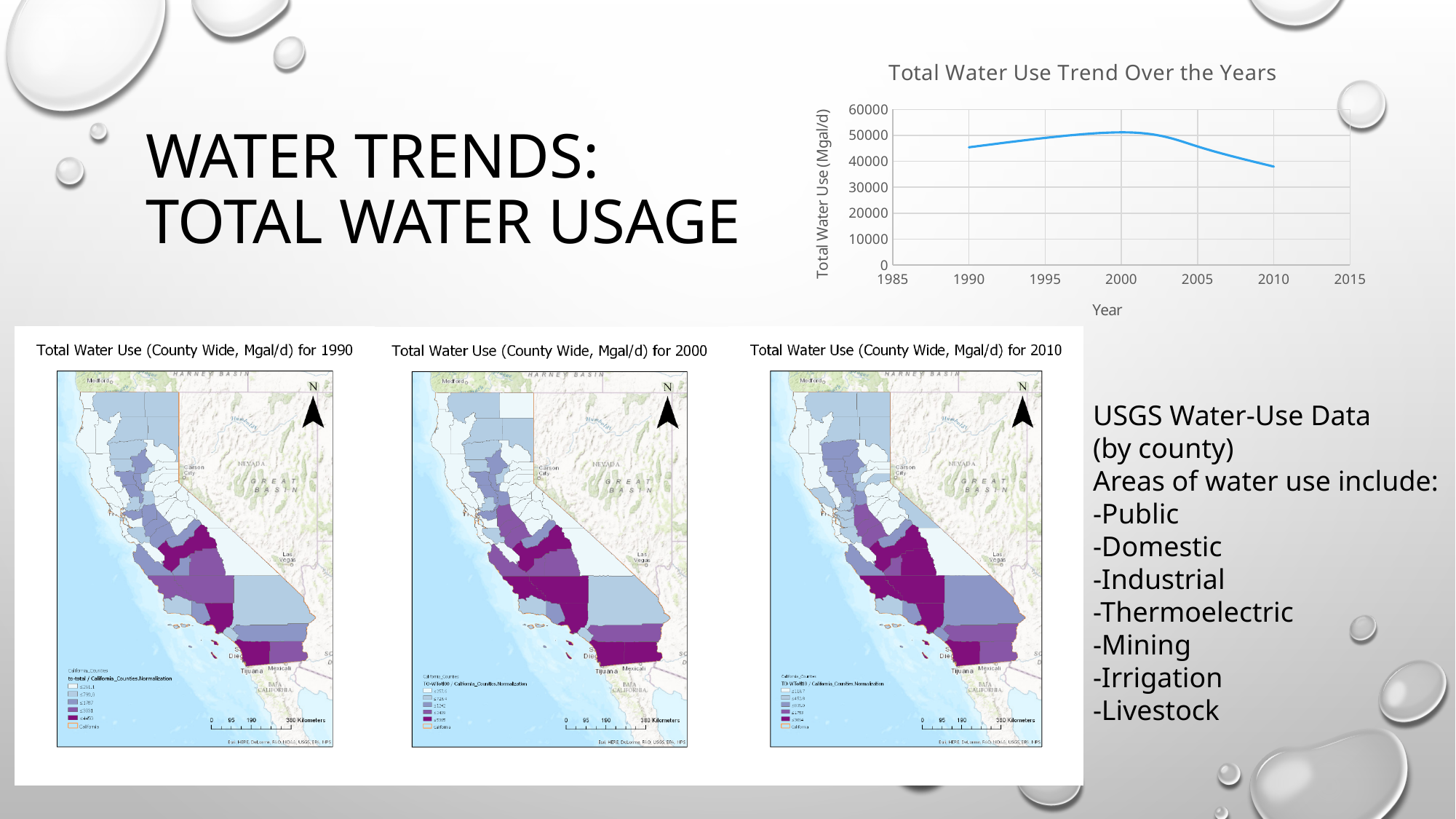
In the "Total Water Use Trend Over the Years" chart, does total water use rise or fall between 1990 and 2000? rise In the "Total Water Use Trend Over the Years" chart, what is the label of the y axis? Total Water Use (Mgal/d) In the "Total Water Use Trend Over the Years" chart, which year has the highest total water use? 2000 In the "Total Water Use Trend Over the Years" chart, does total water use rise or fall between 2000 and 2010? fall In the "Total Water Use Trend Over the Years" chart, is the value for 2010 greater or less than 40000? less In the "Total Water Use Trend Over the Years" chart, is the value for 1990 greater or less than 40000? greater In the "Total Water Use Trend Over the Years" chart, is the value for 2000 greater or less than 50000? greater What is the title of the chart at the top right of the slide? Total Water Use Trend Over the Years In the "Total Water Use Trend Over the Years" chart, which year has the lowest total water use? 2010 What kind of chart is "Total Water Use Trend Over the Years"? line chart In the "Total Water Use Trend Over the Years" chart, which is larger, the value for 1990 or the value for 2010? 1990